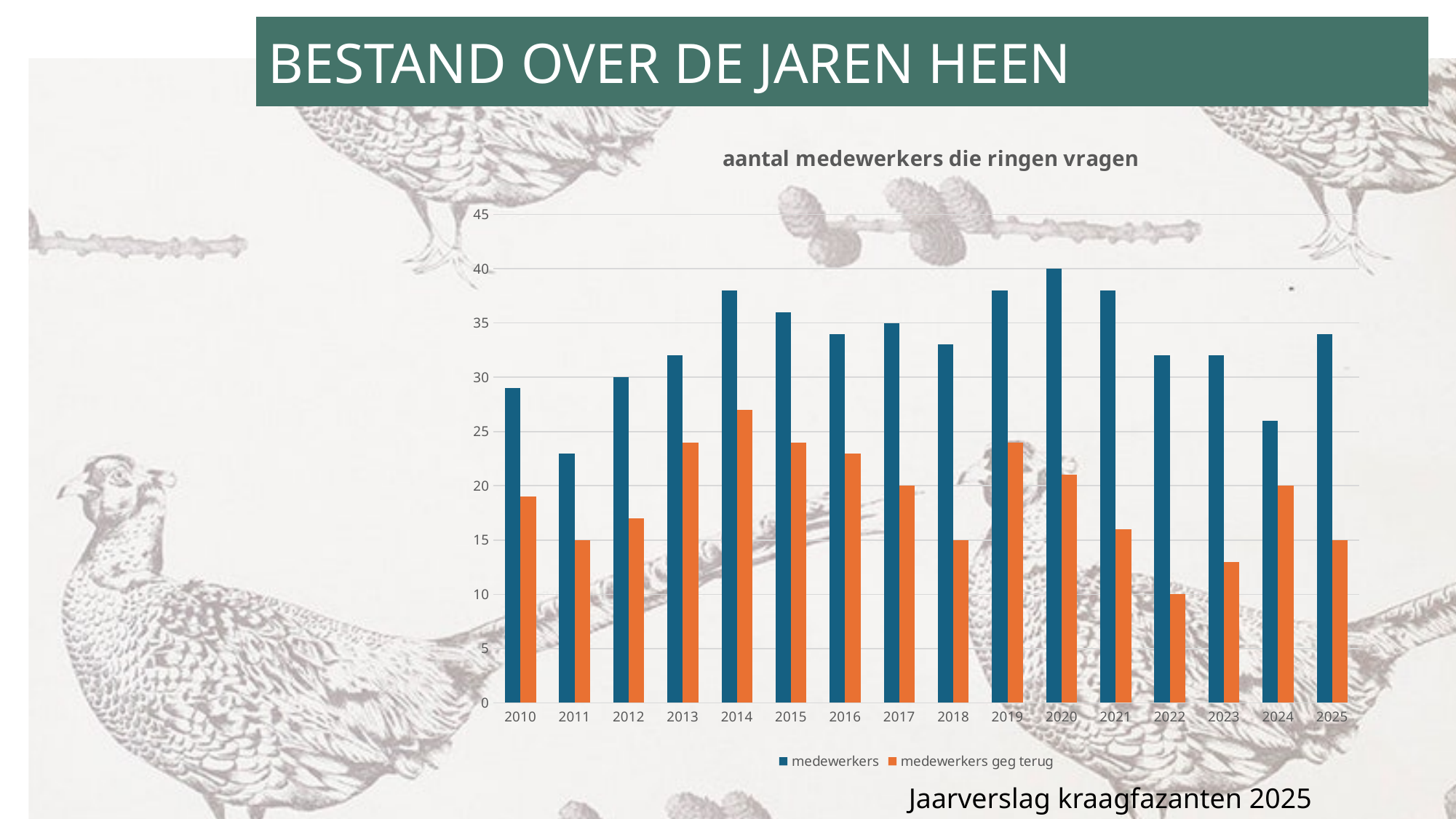
Is the value for medewerkers in 2014 greater or less than 35? greater In which year is the value for medewerkers the highest? 2020 In which year is the value for medewerkers geg terug the lowest? 2022 How many years are shown on the x axis? 16 What is the value for medewerkers geg terug in 2022? 10 Is the value for medewerkers geg terug in 2010 greater or less than 20? less Which is larger: the value for medewerkers in 2014 or in 2011? 2014 How many series does the legend list? 2 In which year is the value for medewerkers the lowest? 2011 What is the title of the chart? aantal medewerkers die ringen vragen What kind of chart is shown on the slide? bar chart What is the value for medewerkers in 2020? 40